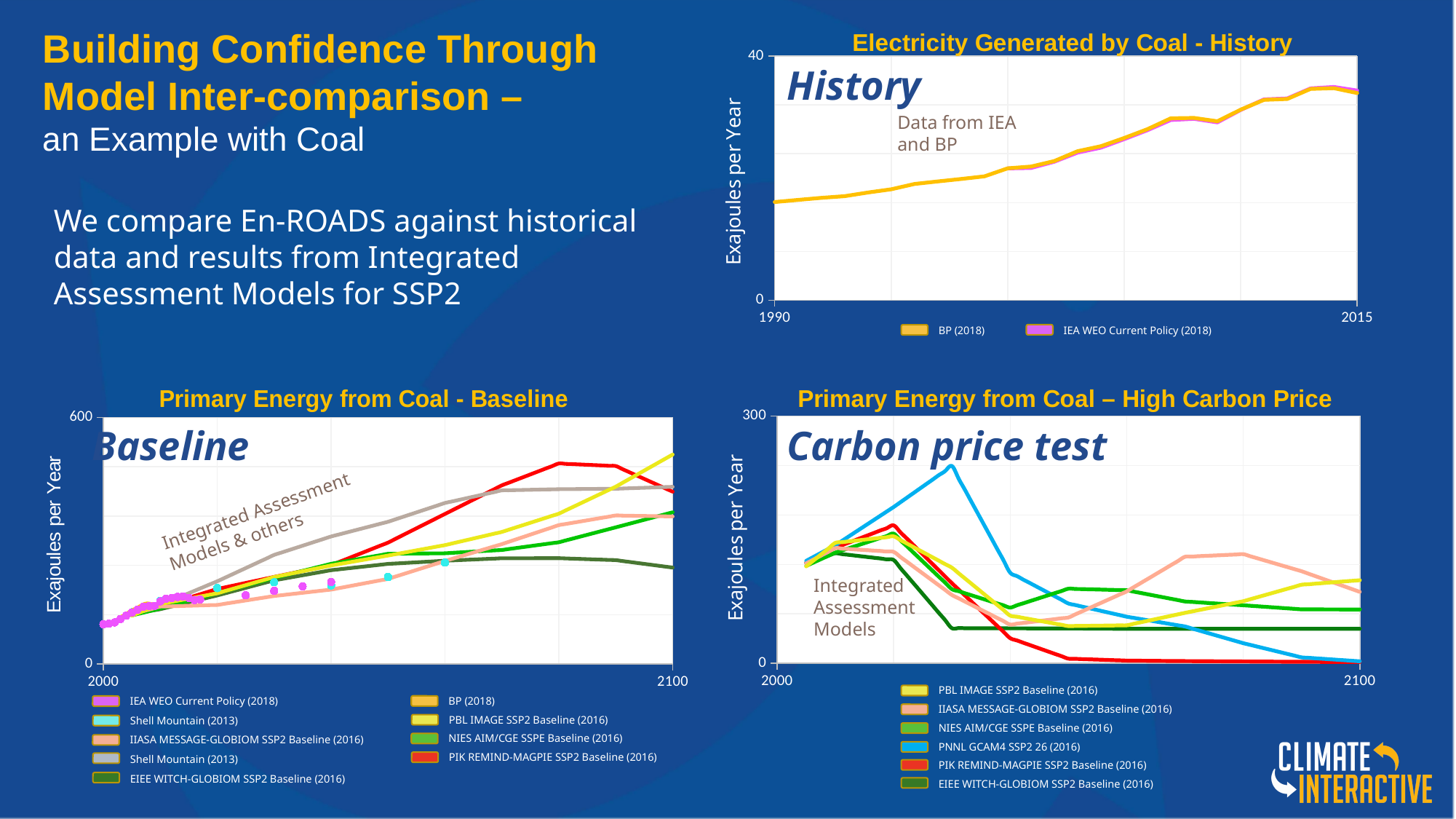
In the 'Electricity Generated by Coal - History' chart, is the value for BP (2018) in 2015 greater or less than 40? less In the 'Primary Energy from Coal - Baseline' chart, which is larger at 2100: PIK REMIND-MAGPIE SSP2 Baseline (2016) or NIES AIM/CGE SSPE Baseline (2016)? PIK REMIND-MAGPIE SSP2 Baseline (2016) In the 'Primary Energy from Coal – High Carbon Price' chart, which is larger at 2100: IIASA MESSAGE-GLOBIOM SSP2 Baseline (2016) or EIEE WITCH-GLOBIOM SSP2 Baseline (2016)? IIASA MESSAGE-GLOBIOM SSP2 Baseline (2016) In the 'Primary Energy from Coal – High Carbon Price' chart, which series reaches the highest peak value? PNNL GCAM4 SSP2 26 (2016) How many series does the legend of the 'Electricity Generated by Coal - History' chart list? 2 In the 'Primary Energy from Coal - Baseline' chart, which series has the lowest value at 2100? EIEE WITCH-GLOBIOM SSP2 Baseline (2016) How many series does the legend of the 'Primary Energy from Coal – High Carbon Price' chart list? 6 In the 'Primary Energy from Coal - Baseline' chart, which series has the highest value at 2100? PBL IMAGE SSP2 Baseline (2016) In the 'Electricity Generated by Coal - History' chart, do the values rise or fall from 1990 to 2015? rise How many series does the legend of the 'Primary Energy from Coal - Baseline' chart list? 9 What kind of chart is the 'Electricity Generated by Coal - History' chart? line chart What is the y-axis label of the 'Primary Energy from Coal - Baseline' chart? Exajoules per Year